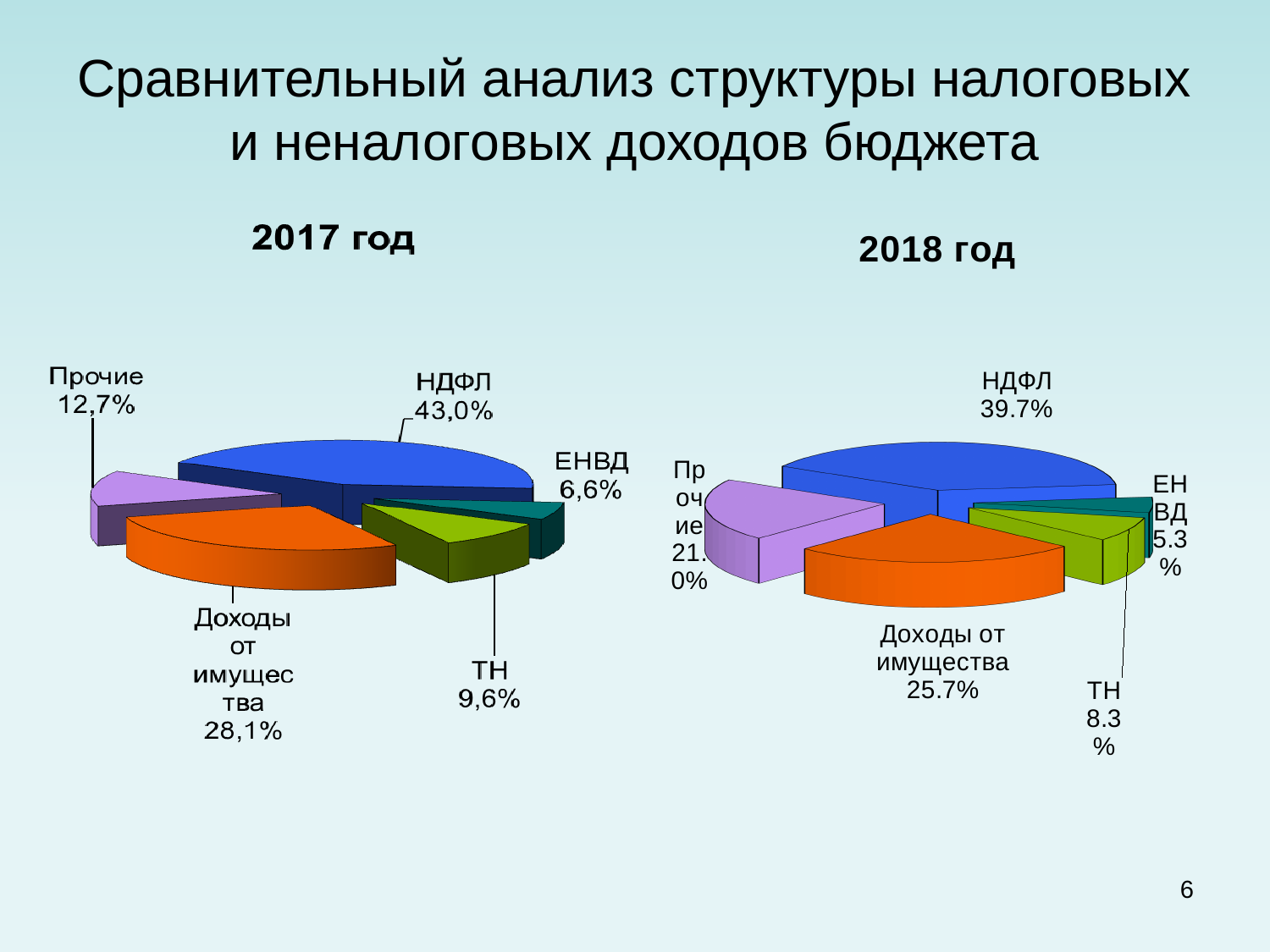
In the 2017 год pie chart, what is the value for Доходы от имущества? 28,1% What type of chart is used for 2018 год? Pie chart In the 2018 год pie chart, which category has the largest share? НДФЛ In the 2018 год pie chart, what is the value for Доходы от имущества? 25.7% In the 2018 год pie chart, what share does НДФЛ have? 39.7% How many slices does the 2017 год pie chart have? 5 In the 2017 год pie chart, what is the value for ТН? 9,6% In the 2018 год pie chart, which is larger: ТН or ЕНВД? ТН In the 2018 год pie chart, what is the value for ЕНВД? 5.3% In the 2017 год pie chart, which category has the smallest share? ЕНВД In the 2017 год pie chart, what is the difference between the shares of Прочие and ЕНВД? 6,1% In the 2017 год pie chart, what share does НДФЛ have? 43,0%